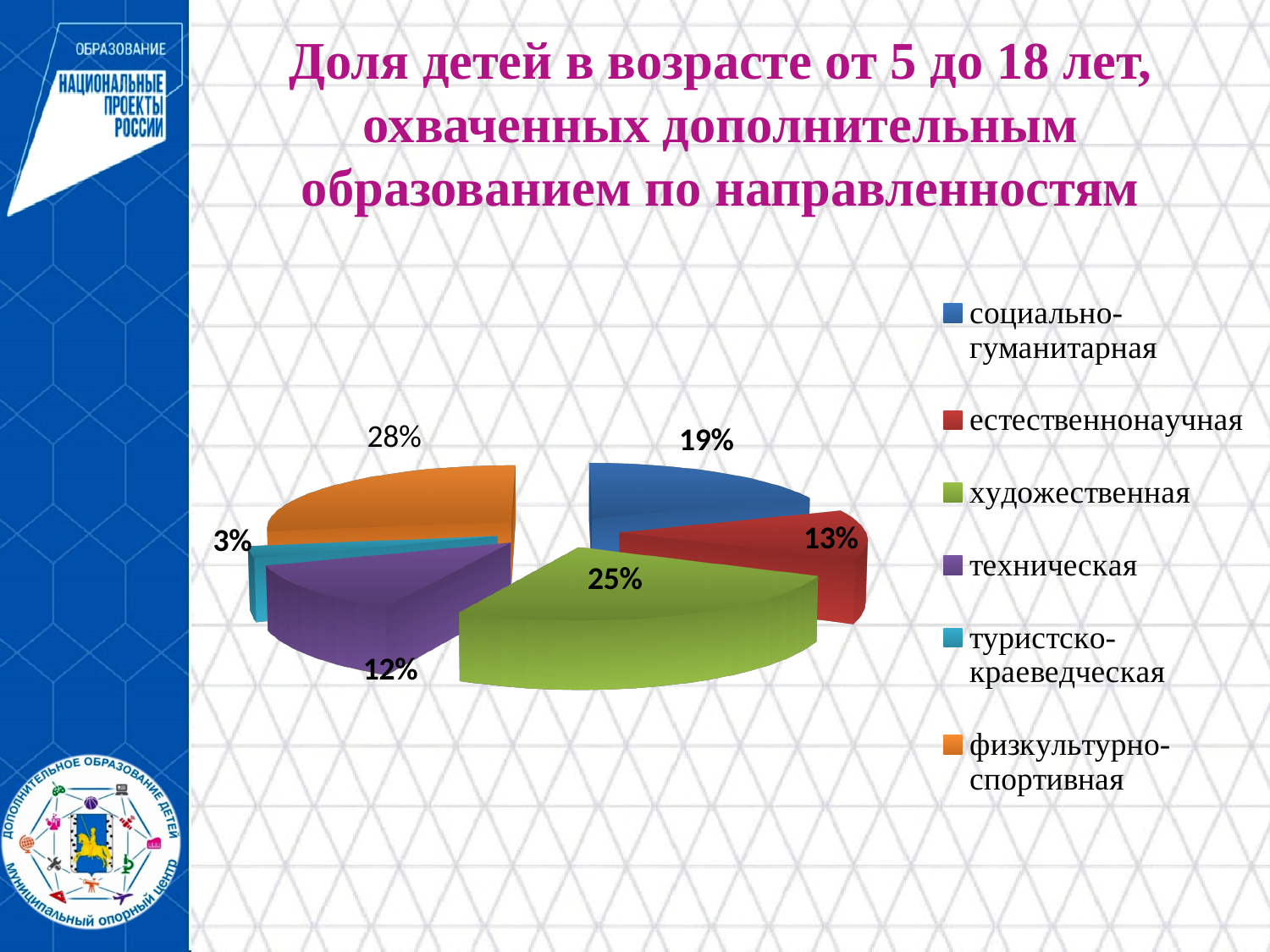
What share of the pie does the художественная slice have? 25% What kind of chart is shown on the slide? pie chart What is the value shown for физкультурно-спортивная? 28% What is the difference between the shares of физкультурно-спортивная and техническая? 16% Which category has the largest share of the pie? физкультурно-спортивная How many slices does the pie chart have? 6 What colour is the slice for техническая? purple Which category has the smallest share of the pie? туристско-краеведческая What is the value shown for социально-гуманитарная? 19% Which is larger, the share for естественнонаучная or the share for социально-гуманитарная? социально-гуманитарная How many entries does the legend list? 6 What is the value shown for туристско-краеведческая? 3%